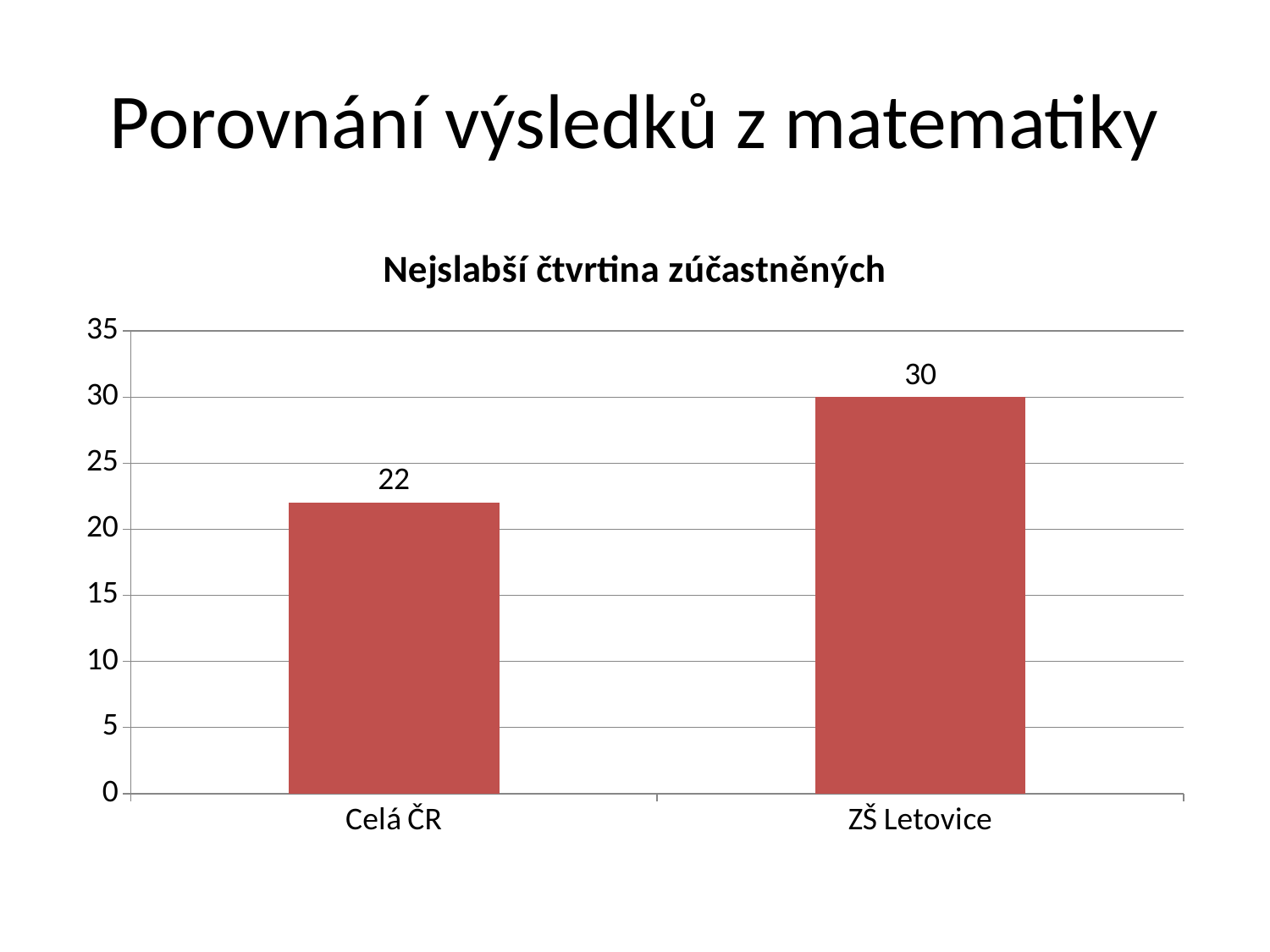
Which category has the highest value? ZŠ Letovice Which is larger, the value for Celá ČR or the value for ZŠ Letovice? ZŠ Letovice Is the value for ZŠ Letovice greater or less than 25? greater What is the value for Celá ČR? 22 What kind of chart is shown on the slide? bar chart Is the value for Celá ČR greater or less than 25? less What is the difference between the values for ZŠ Letovice and Celá ČR? 8 What is the title of the chart? Nejslabší čtvrtina zúčastněných What is the value for ZŠ Letovice? 30 Which category has the lowest value? Celá ČR How many categories are shown in the chart? 2 What is the maximum value shown on the vertical axis? 35